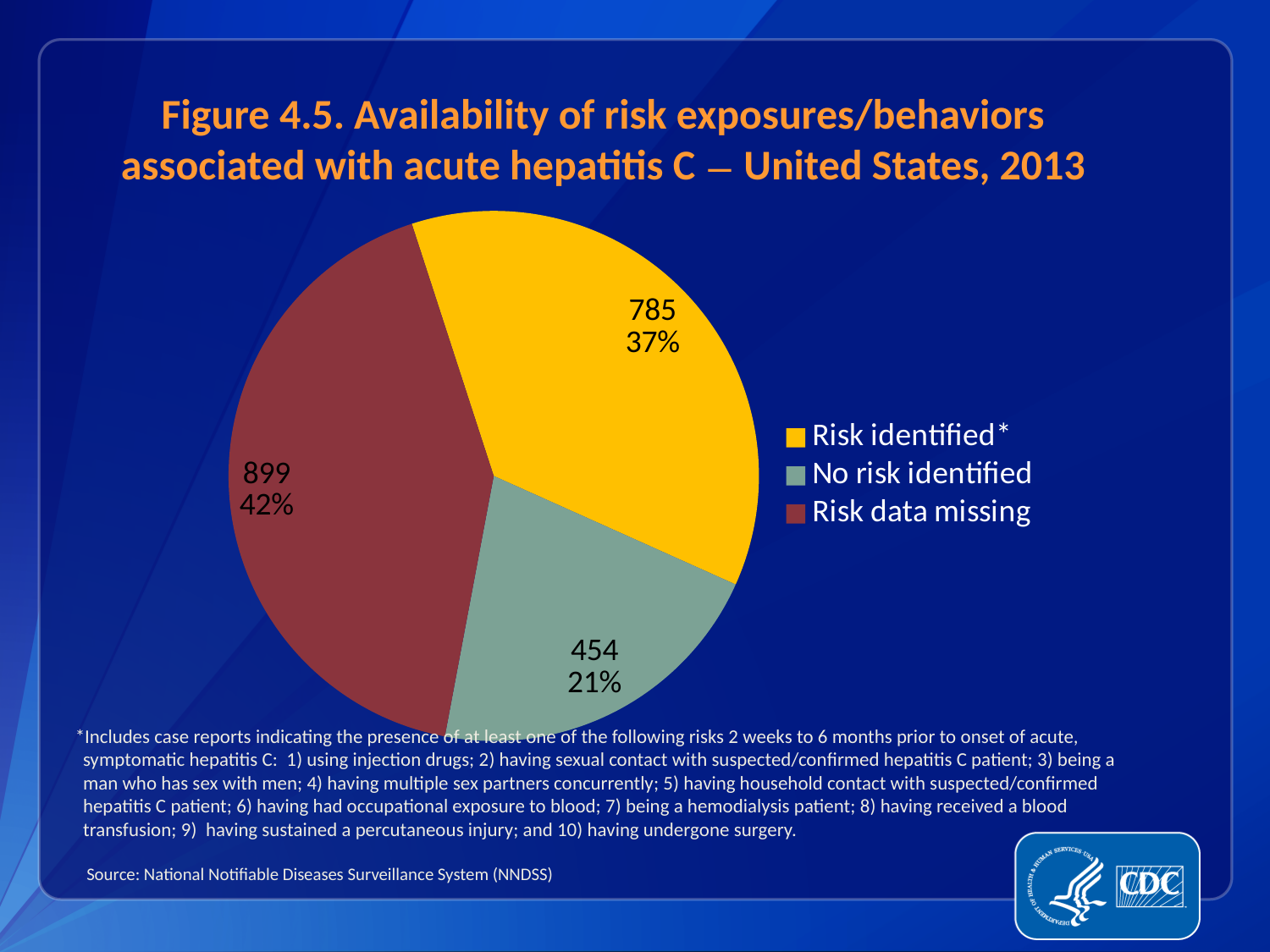
How many cases are in the 'Risk identified*' slice? 785 Which category has the largest slice of the pie? Risk data missing What is the difference in number of cases between 'Risk data missing' and 'Risk identified*'? 114 What percentage of cases had no risk identified? 21% What type of chart is shown on the slide? pie chart What colour is the 'No risk identified' slice? grey-green How many categories does the pie chart show? 3 What share of the pie does 'Risk data missing' represent? 42% What is the total number of cases across all three slices? 2,138 How many cases are in the 'Risk data missing' slice? 899 Which is larger: the number of cases with risk identified or the number with no risk identified? Risk identified* Which category has the smallest slice of the pie? No risk identified